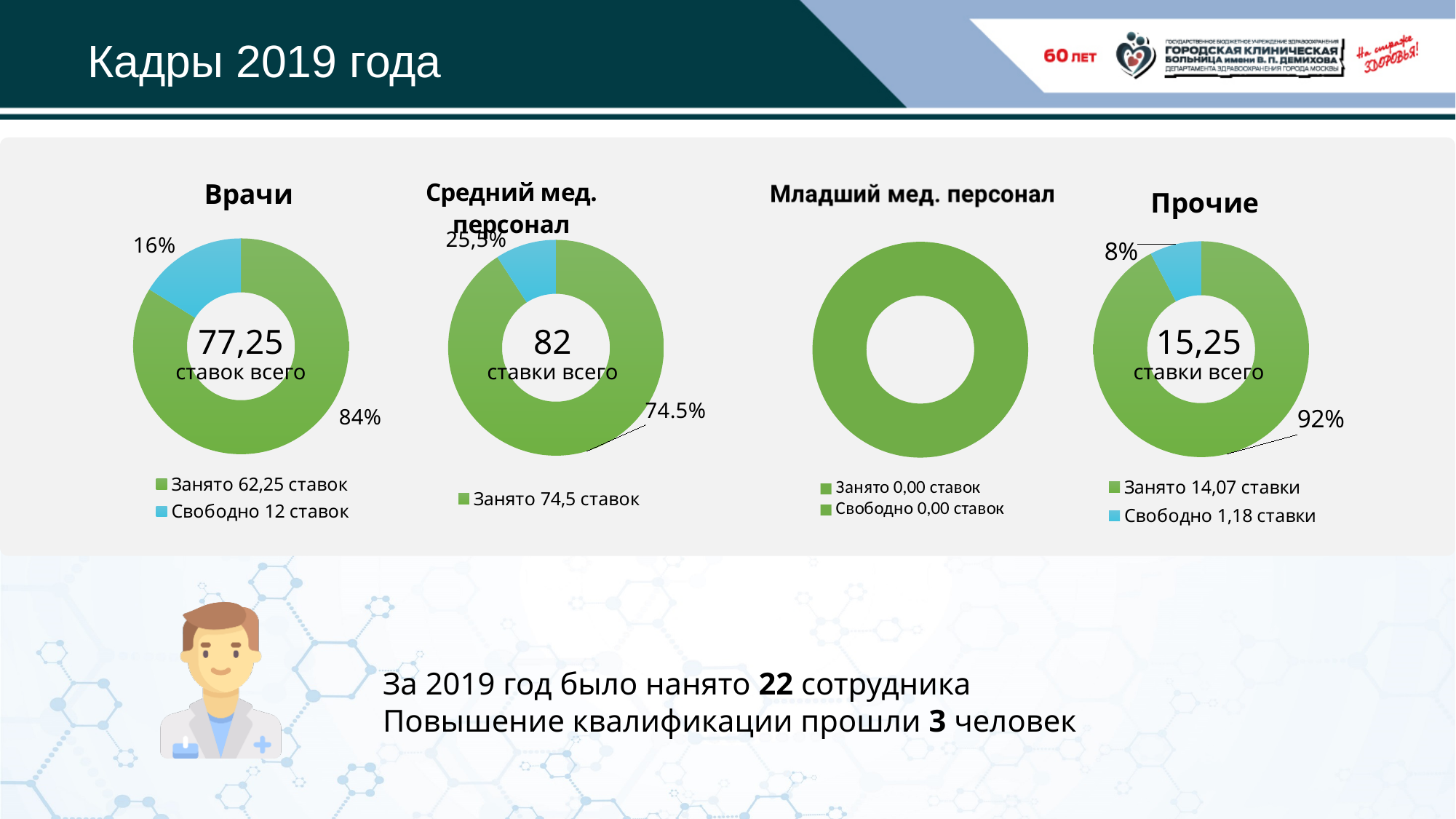
How many donut charts are shown on the slide? 4 In the "Прочие" chart, which slice is larger, Занято or Свободно? Занято What total number is printed in the centre of the "Врачи" chart? 77,25 In the "Прочие" chart, what percentage label is on the green slice? 92% In the "Врачи" chart, what percentage is shown for the blue (Свободно) slice? 16% In the "Врачи" chart, how many ставок are listed as Свободно in the legend? 12 ставок In the "Врачи" chart, what percentage is shown for the green (Занято) slice? 84% In the "Прочие" chart, what is the difference in percentage points between the 92% and 8% slices? 84 percentage points How many entries does the legend of the "Младший мед. персонал" chart list? 2 What kind of chart is used for "Врачи"? donut (pie) chart In the "Прочие" chart, what value does the legend give for Свободно? 1,18 ставки What total number is printed in the centre of the "Средний мед. персонал" chart? 82